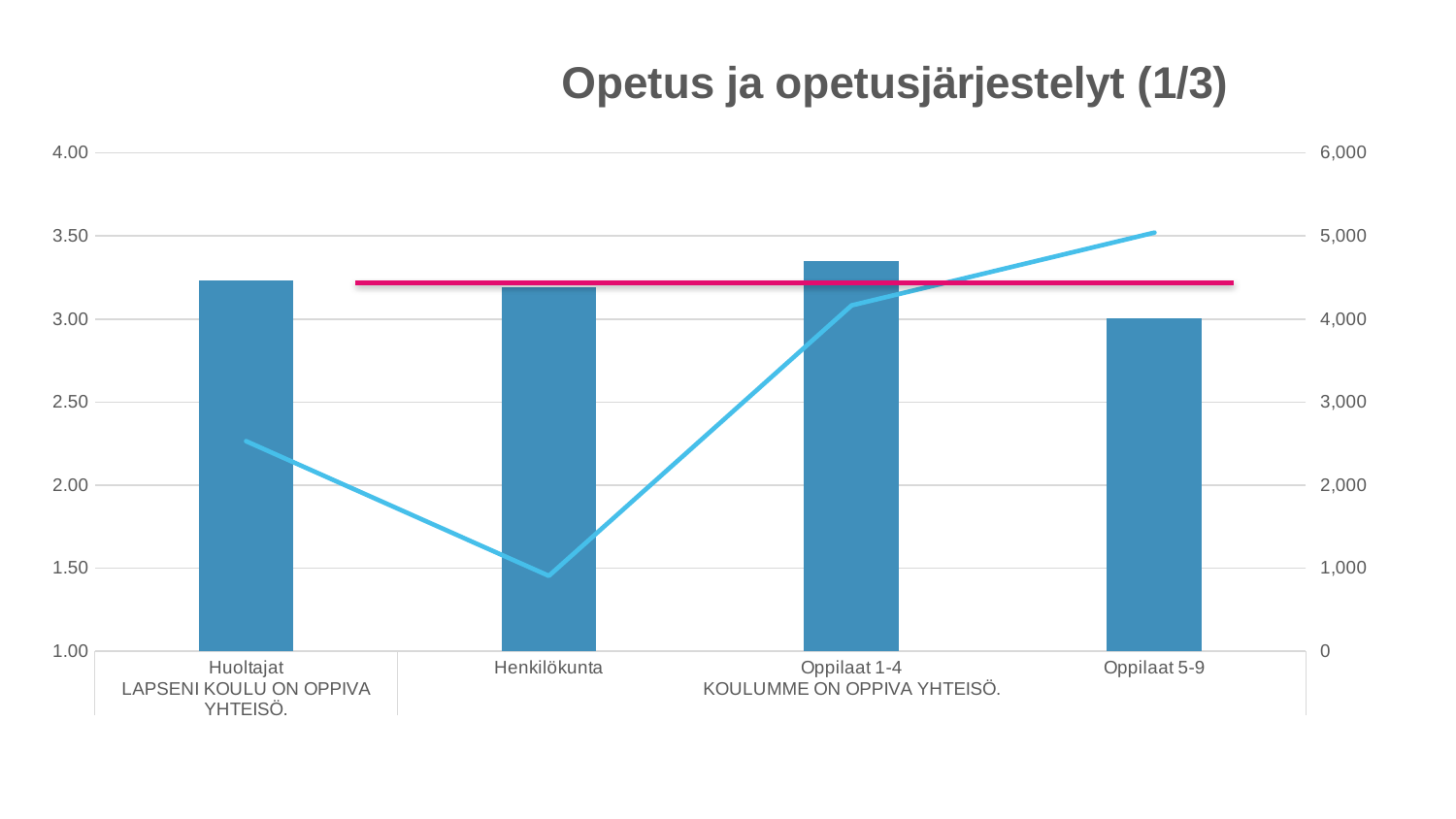
Which category has the lowest point on the light blue line? Henkilökunta Which category has the highest bar? Oppilaat 1-4 Is the bar value for Henkilökunta greater or less than 3.50? less Which category has the highest point on the light blue line? Oppilaat 5-9 Is the light blue line value for Huoltajat greater or less than 2,000? greater Is the bar value for Oppilaat 1-4 greater or less than 3.00? greater Which category has the lowest bar? Oppilaat 5-9 What is the title of the chart? Opetus ja opetusjärjestelyt (1/3) What kind of chart is this? Bar chart combined with a line chart How many categories are shown on the x axis? 4 Is the bar for Oppilaat 1-4 taller or shorter than the bar for Oppilaat 5-9? taller